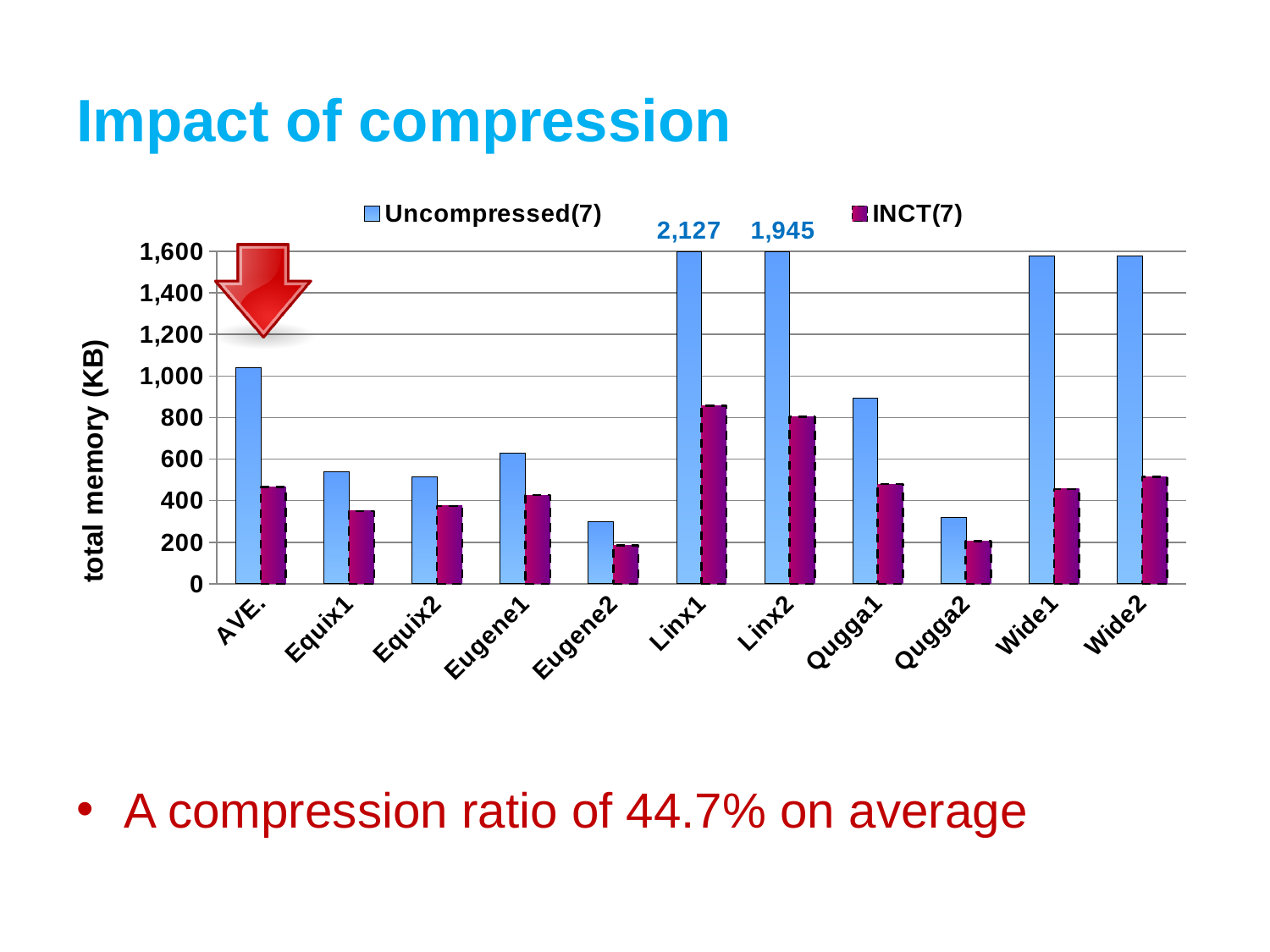
What is the Uncompressed(7) value for Linx2? 1,945 Which category has the highest Uncompressed(7) value? Linx1 What is the difference between the Uncompressed(7) values for Linx1 and Linx2? 182 What is the label on the y axis? total memory (KB) What is the Uncompressed(7) value for Linx1? 2,127 How many series does the legend list? 2 Which is larger, the Uncompressed(7) value for Qugga1 or for Eugene1? Qugga1 What kind of chart is shown on the slide? bar chart Is the Uncompressed(7) value for Eugene2 greater or less than 400? less How many categories are shown along the x axis? 11 Is the Uncompressed(7) value for AVE. greater or less than 800? greater Is the INCT(7) value for Qugga2 greater or less than 400? less